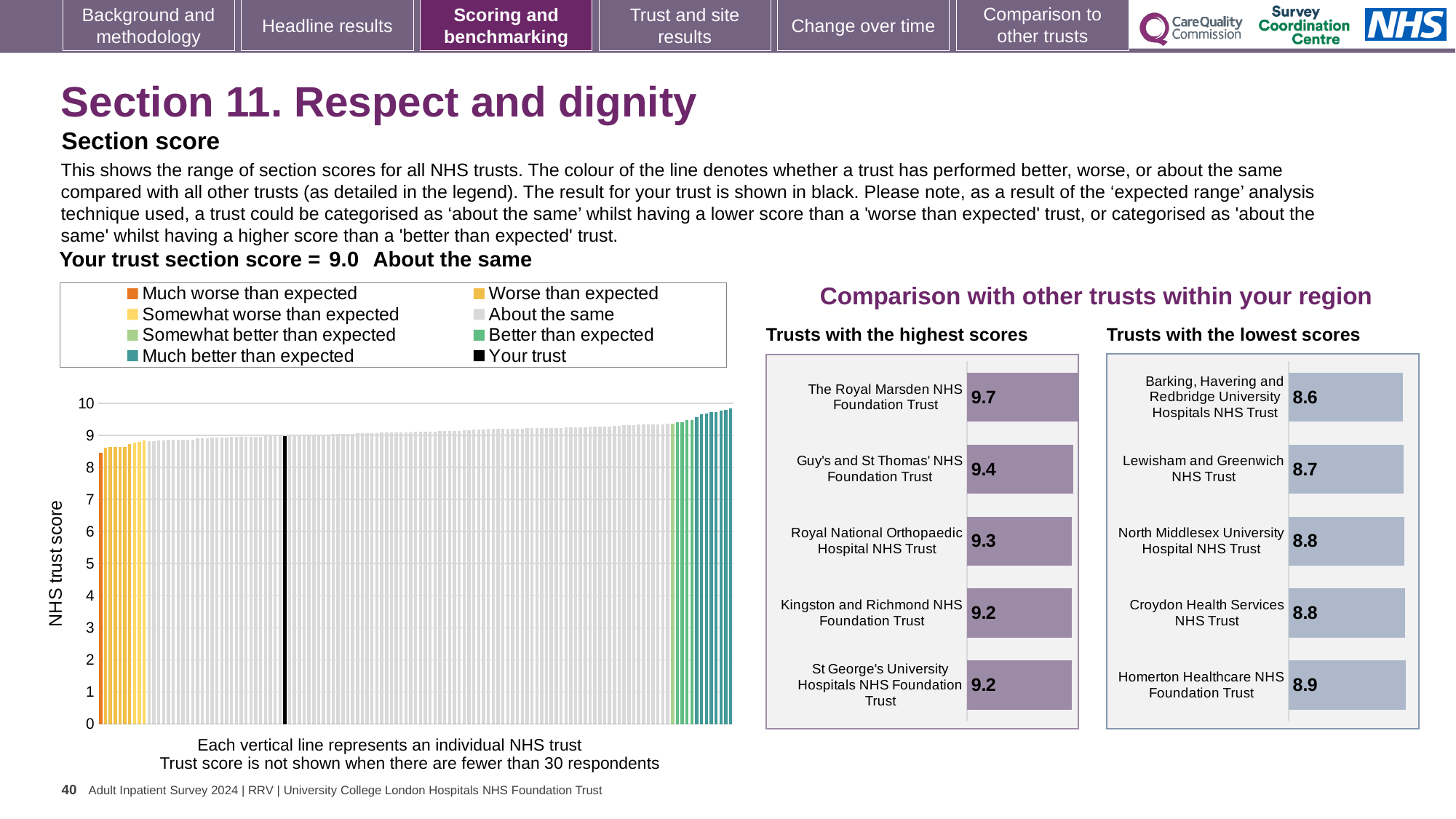
What is the y-axis label of the main chart on the left? NHS trust score In the 'Trusts with the highest scores' chart, which trust has the highest score? The Royal Marsden NHS Foundation Trust In the 'Trusts with the lowest scores' chart, which has the larger score: Lewisham and Greenwich NHS Trust or Homerton Healthcare NHS Foundation Trust? Homerton Healthcare NHS Foundation Trust In the 'Trusts with the lowest scores' chart, how many trusts are shown? 5 What kind of chart is the main 'NHS trust score' chart on the left? Bar chart In the 'Trusts with the lowest scores' chart, which trust has the lowest score? Barking, Havering and Redbridge University Hospitals NHS Trust How many entries does the legend of the main 'NHS trust score' chart list? 8 In the 'Trusts with the highest scores' chart, what is the score for The Royal Marsden NHS Foundation Trust? 9.7 In the 'Trusts with the lowest scores' chart, what is the score for Lewisham and Greenwich NHS Trust? 8.7 In the 'Trusts with the highest scores' chart, what is the difference between the scores of The Royal Marsden NHS Foundation Trust and Guy's and St Thomas' NHS Foundation Trust? 0.3 In the main 'NHS trust score' chart on the left, is the value for the black 'Your trust' bar greater or less than 8? greater In the 'Trusts with the highest scores' chart, what is the score for Royal National Orthopaedic Hospital NHS Trust? 9.3